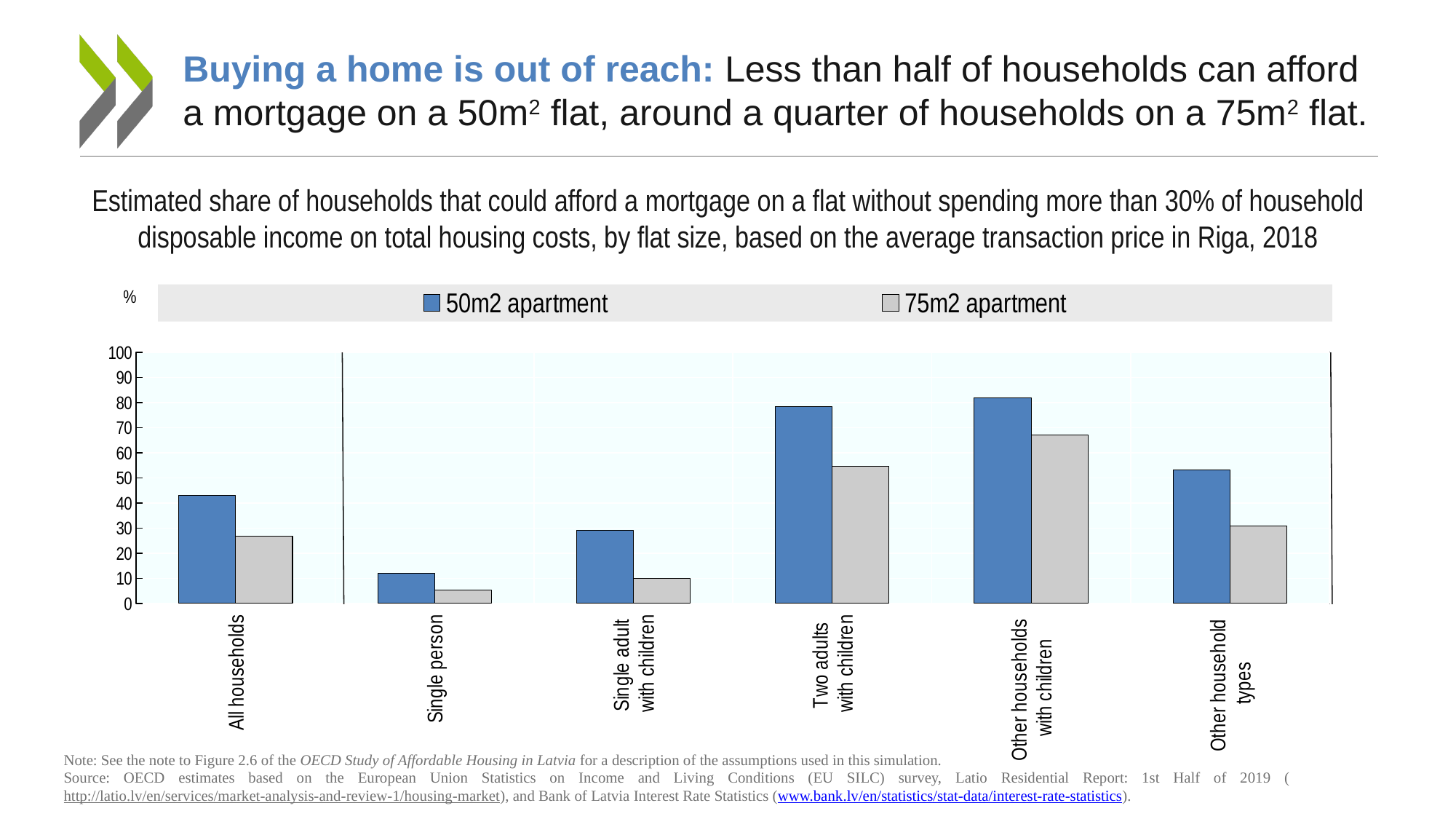
How many household categories are shown on the x axis? 6 What kind of chart is shown on the slide? bar chart Which household category has the highest value for the 75m2 apartment series? Other households with children Which household category has the lowest value for the 50m2 apartment series? Single person For Two adults with children, which is larger: the 50m2 apartment value or the 75m2 apartment value? 50m2 apartment Is the 50m2 apartment value for Two adults with children greater or less than 70? greater Which series is shown in blue in the legend? 50m2 apartment Is the 75m2 apartment value for Other households with children greater or less than 60? greater How many series does the legend list? 2 Which household category has the lowest value for the 75m2 apartment series? Single person Is the 75m2 apartment value for All households greater or less than 30? less